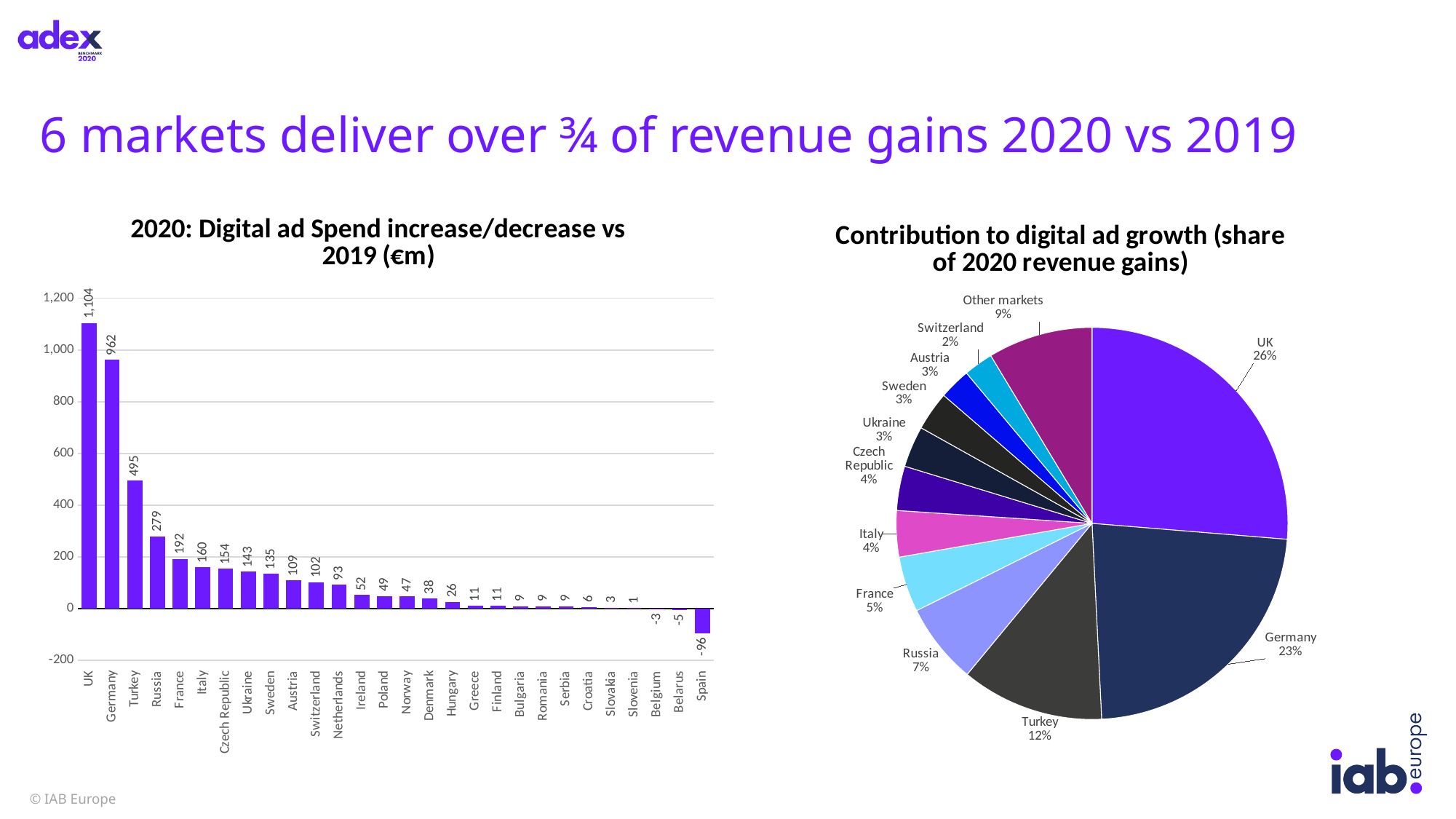
What is the title of the chart on the right? Contribution to digital ad growth (share of 2020 revenue gains) How many markets are shown in the bar chart on the left? 28 In the pie chart on the right, which market has the largest share? UK In the bar chart on the left, what is the difference between the values for UK and Germany? 142 How many slices does the pie chart on the right have? 12 In the bar chart on the left, which market has the highest value? UK In the bar chart on the left, which market has the lowest value? Spain In the pie chart on the right, what share does Germany have? 23% In the bar chart on the left, what is the value for Turkey? 495 In the bar chart on the left, what is the value for Spain? -96 What kind of chart is the chart on the left? Bar chart In the bar chart on the left, which is larger, the value for Russia or the value for France? Russia